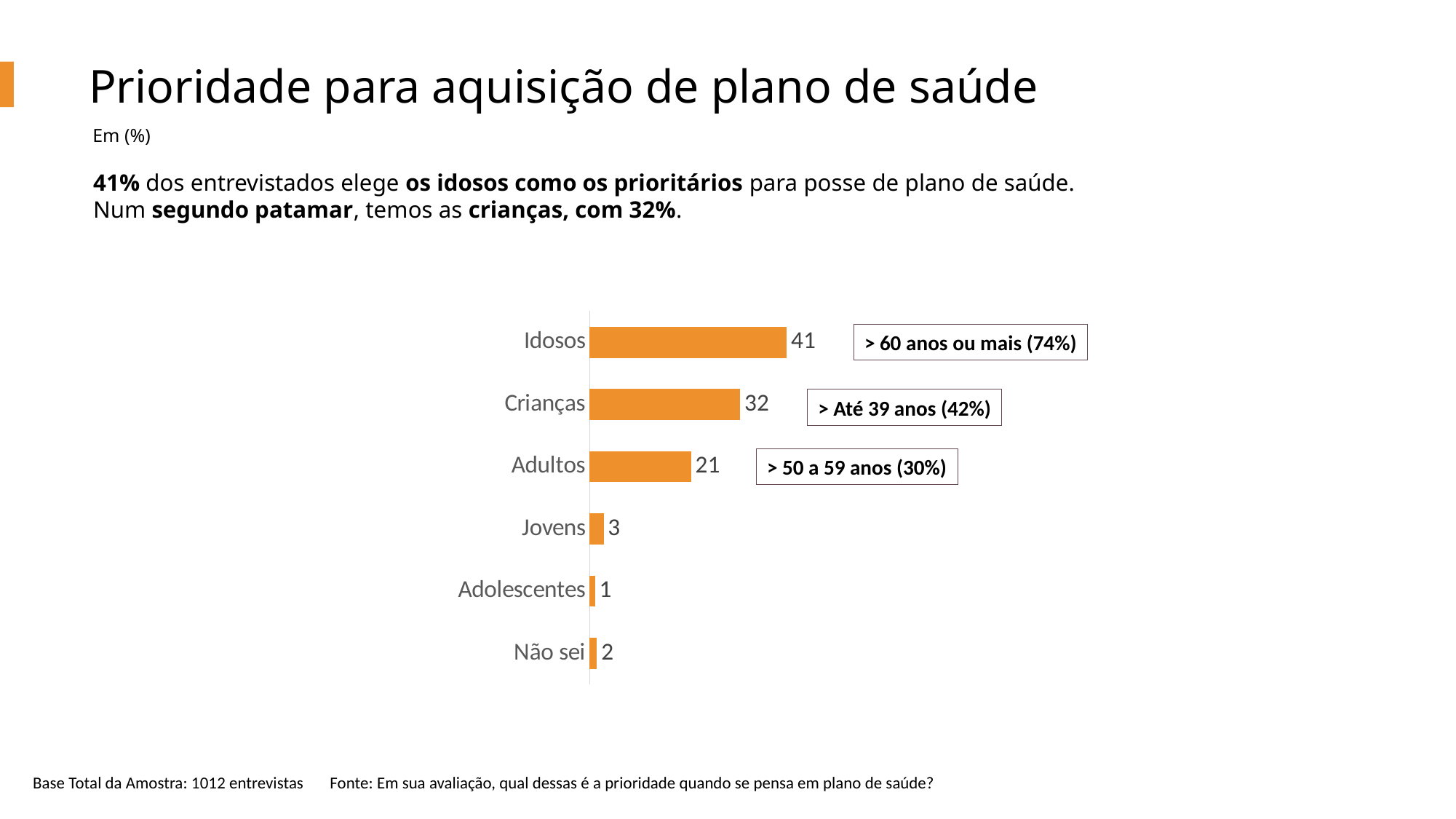
Which category has the lowest value? Adolescentes What kind of chart is shown on the slide? Bar chart What is the difference between the values for Idosos and Crianças? 9 What is the value for Jovens? 3 What is the value for Idosos? 41 How many categories are shown in the chart? 6 What is the value for Adultos? 21 Which is larger, the value for Adultos or the value for Jovens? Adultos What is the value for Não sei? 2 Which category has the highest value? Idosos What is the value for Crianças? 32 What is the title of the slide containing the chart? Prioridade para aquisição de plano de saúde